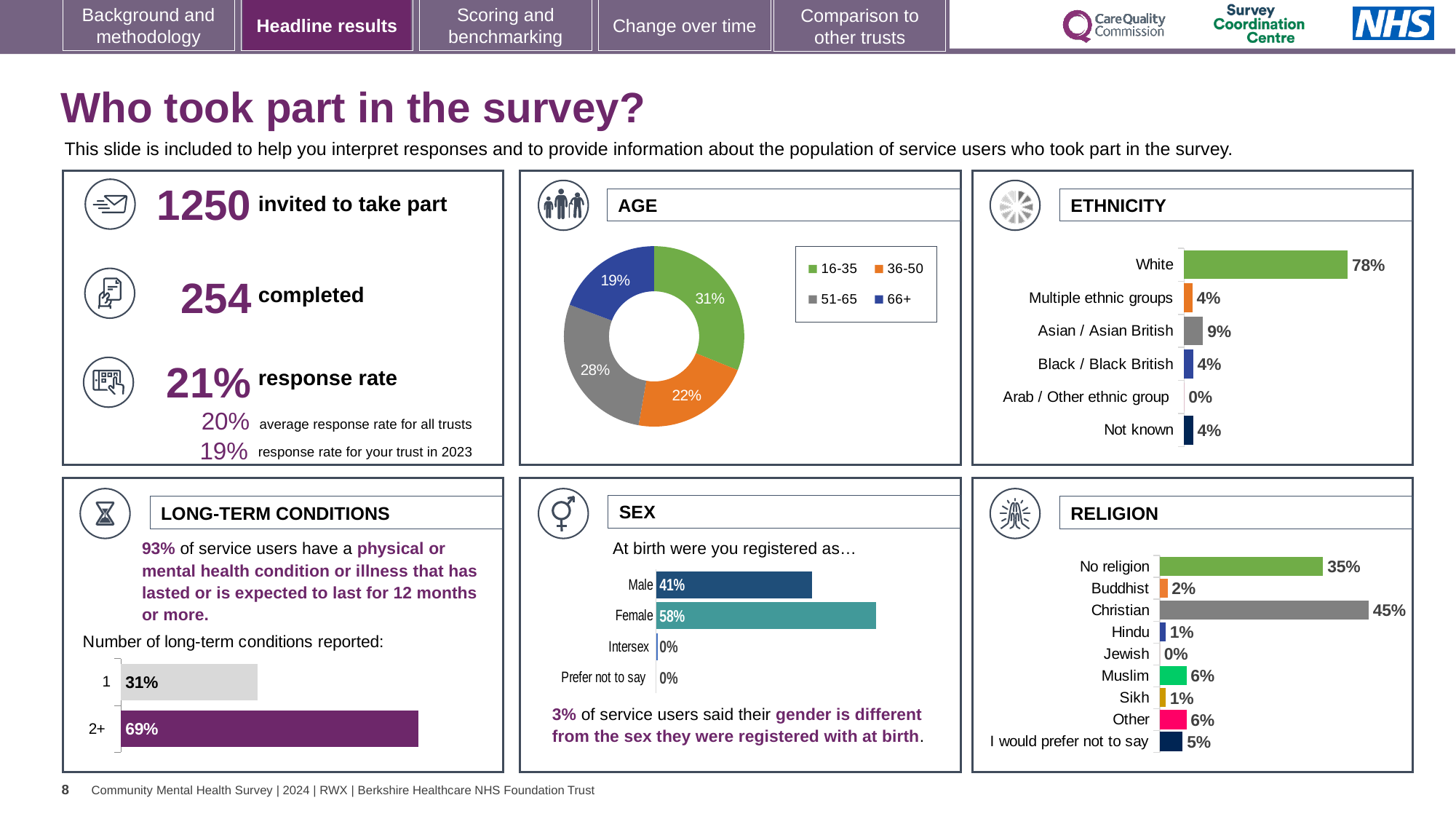
In the ETHNICITY chart, which category has the highest value? White How many categories are shown in the ETHNICITY chart? 6 In the SEX chart, what is the value for Female? 58% In the AGE chart, what share of respondents were aged 16-35? 31% In the ETHNICITY chart, what is the difference between White and Asian / Asian British? 69% In the RELIGION chart, which category has the highest value? Christian In the LONG-TERM CONDITIONS chart, what percentage reported 2+ conditions? 69% What kind of chart is the AGE chart? Donut (pie) chart In the SEX chart, which is larger, Male or Female? Female In the AGE chart, which age group has the smallest share? 66+ How many age groups does the legend of the AGE chart list? 4 In the ETHNICITY chart, what is the value for Asian / Asian British? 9%